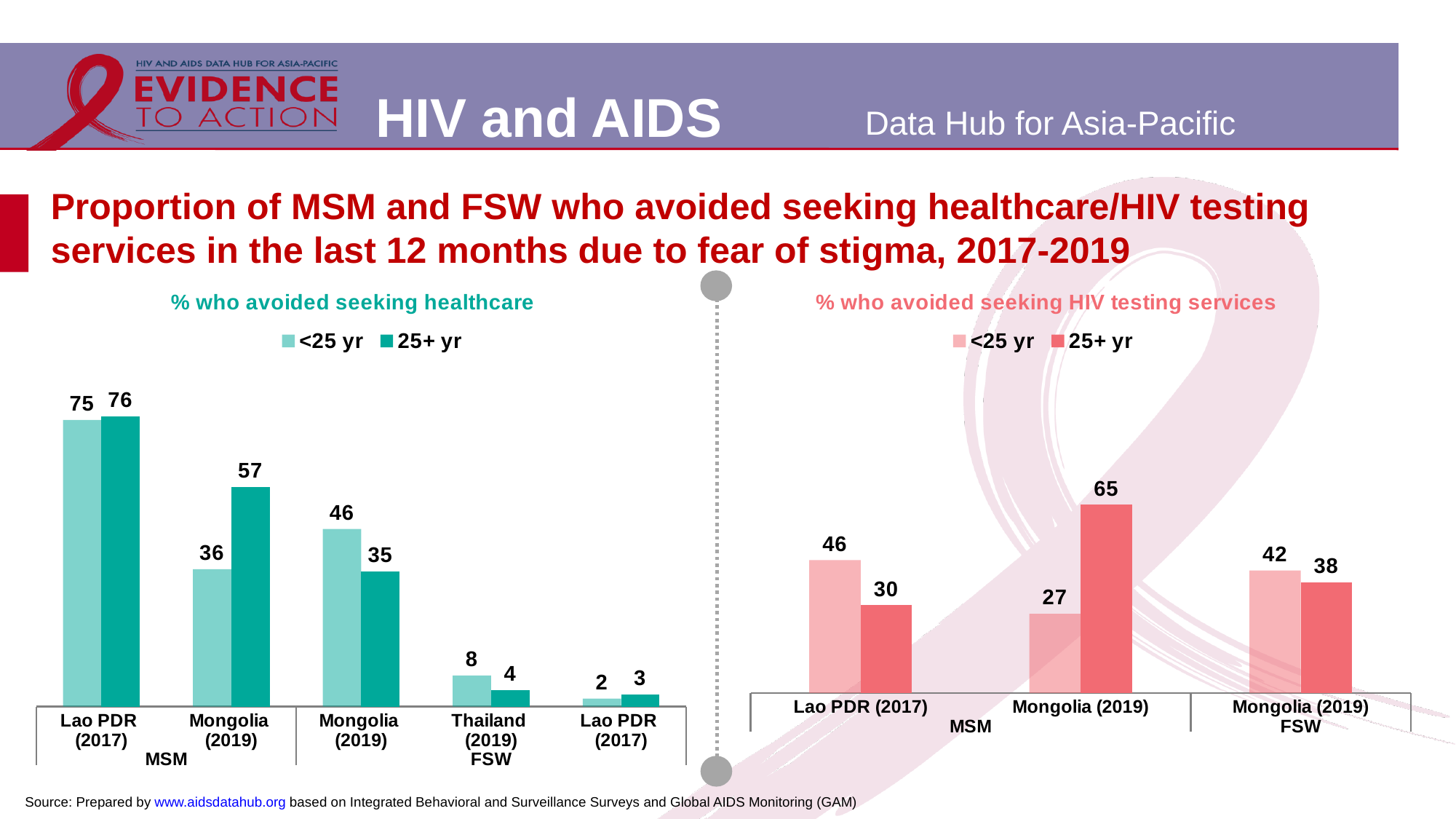
In the '% who avoided seeking healthcare' chart, what is the difference between the <25 yr and 25+ yr values for FSW in Mongolia (2019)? 11 In the '% who avoided seeking healthcare' chart, what is the value for 25+ yr MSM in Mongolia (2019)? 57 What type of chart is the '% who avoided seeking healthcare' chart? Bar chart In the '% who avoided seeking HIV testing services' chart, what is the value for 25+ yr MSM in Mongolia (2019)? 65 In the '% who avoided seeking HIV testing services' chart, what is the difference between the 25+ yr and <25 yr values for MSM in Mongolia (2019)? 38 In the '% who avoided seeking HIV testing services' chart, which is larger for MSM in Lao PDR (2017): the <25 yr value or the 25+ yr value? <25 yr In the '% who avoided seeking healthcare' chart, which category has the highest 25+ yr value? Lao PDR (2017) MSM How many series does the legend of the '% who avoided seeking HIV testing services' chart list? 2 In the '% who avoided seeking HIV testing services' chart, what is the value for <25 yr FSW in Mongolia (2019)? 42 How many categories are shown on the x axis of the '% who avoided seeking healthcare' chart? 5 In the '% who avoided seeking healthcare' chart, what is the value for <25 yr MSM in Lao PDR (2017)? 75 In the '% who avoided seeking healthcare' chart, which category has the lowest <25 yr value? Lao PDR (2017) FSW